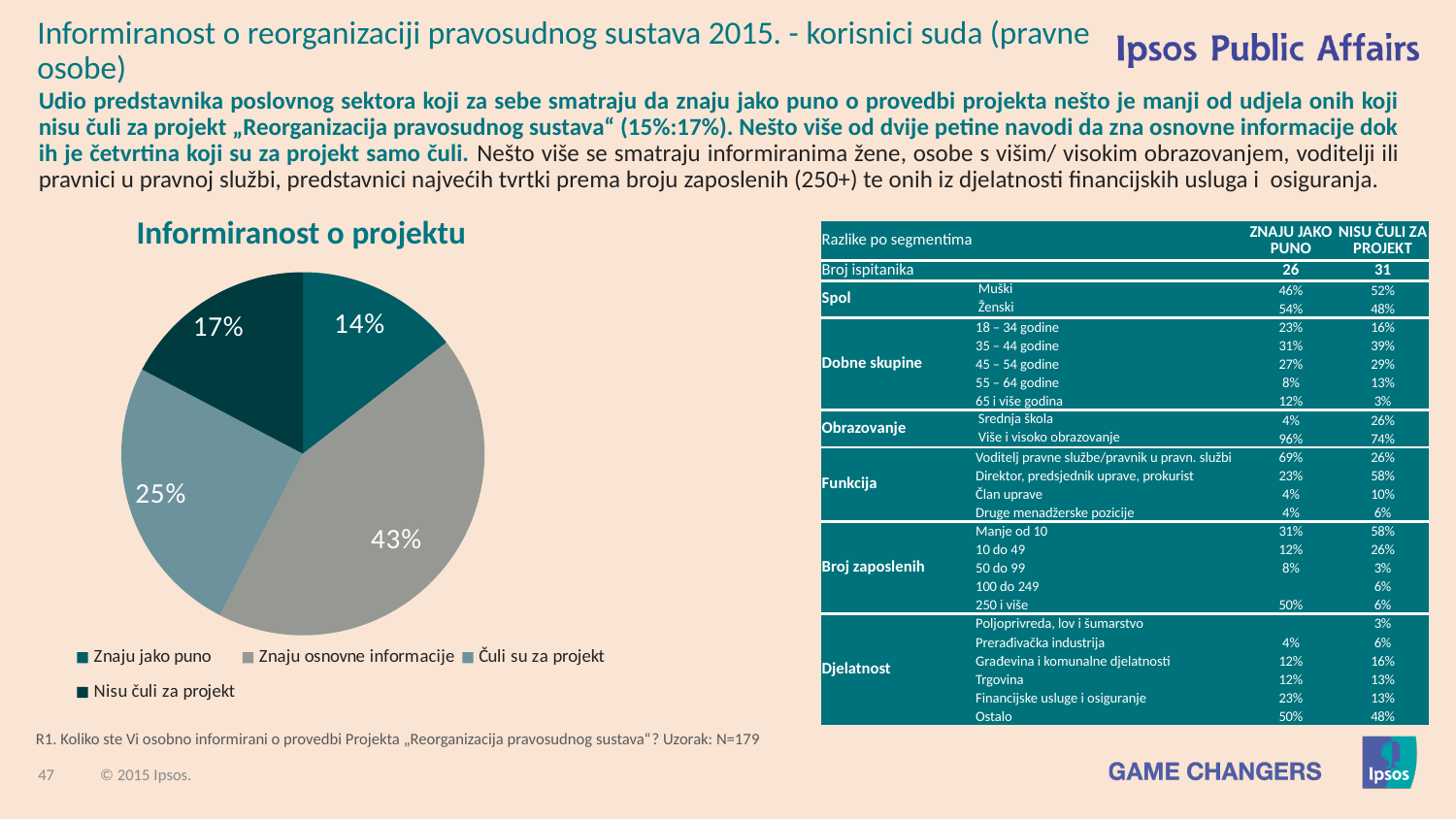
In the pie chart 'Informiranost o projektu', what share is labelled for 'Nisu čuli za projekt'? 17% In the pie chart 'Informiranost o projektu', what share is labelled for 'Čuli su za projekt'? 25% In the pie chart 'Informiranost o projektu', what share is labelled for 'Znaju jako puno'? 14% In the pie chart 'Informiranost o projektu', what is the difference between the shares for 'Znaju osnovne informacije' and 'Čuli su za projekt'? 18% What is the title of the pie chart on the left of the slide? Informiranost o projektu In the pie chart 'Informiranost o projektu', which category has the smallest slice? Znaju jako puno In the pie chart 'Informiranost o projektu', which is larger: 'Nisu čuli za projekt' or 'Znaju jako puno'? Nisu čuli za projekt In the pie chart 'Informiranost o projektu', what share is labelled for 'Znaju osnovne informacije'? 43% How many entries does the legend of the pie chart 'Informiranost o projektu' list? 4 How many slices does the pie chart 'Informiranost o projektu' have? 4 In the pie chart 'Informiranost o projektu', which category has the largest slice? Znaju osnovne informacije What type of chart is 'Informiranost o projektu'? pie chart